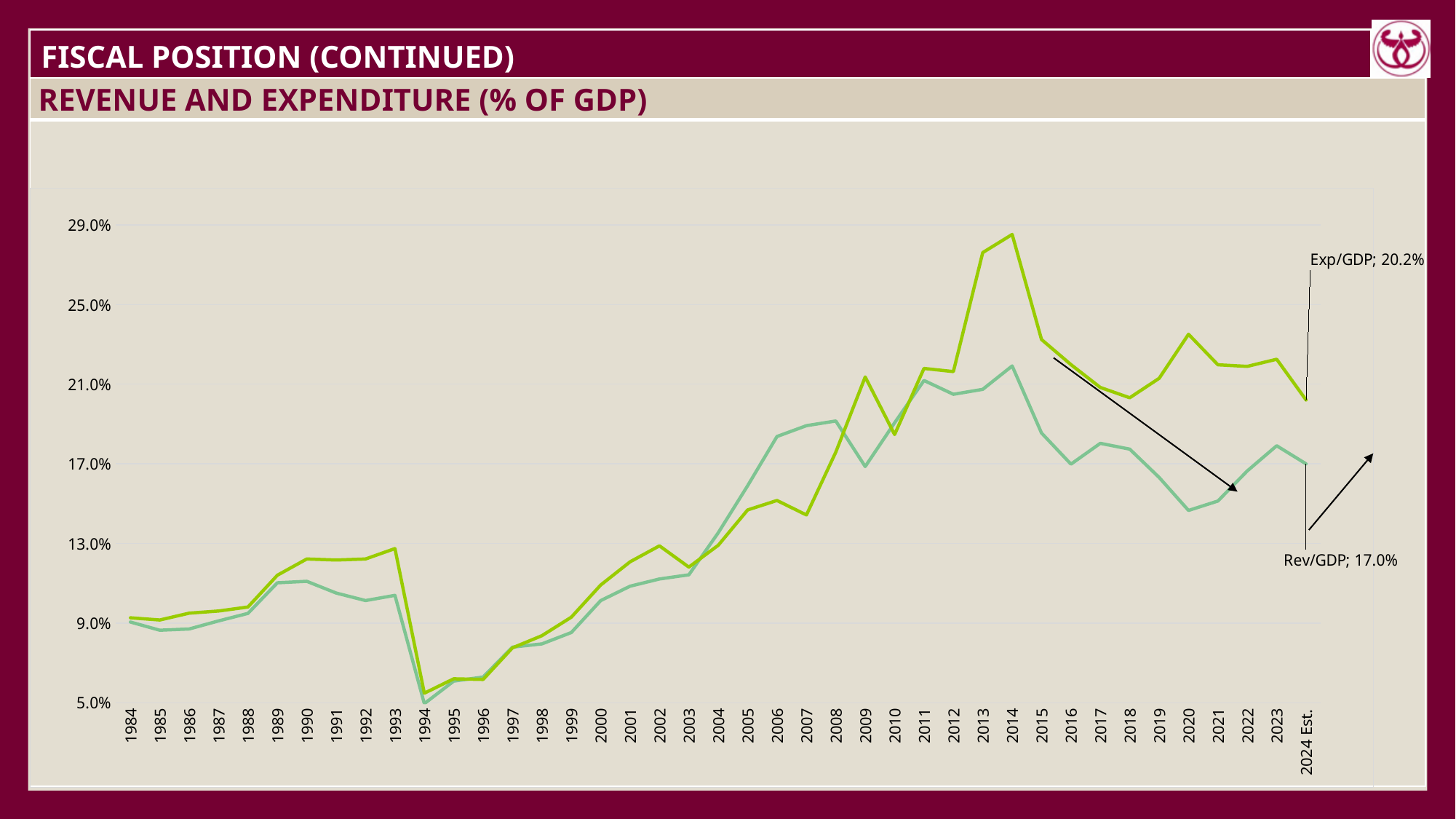
Is the value for Rev/GDP in 1994 greater or less than 9.0%? less What kind of chart is shown on the slide? Line chart What is the value of Exp/GDP for 2024 Est.? 20.2% In which year does the Rev/GDP line reach its lowest value? 1994 What is the difference between Exp/GDP and Rev/GDP for 2024 Est.? 3.2% What is the title of the chart? REVENUE AND EXPENDITURE (% OF GDP) Does the Exp/GDP line rise or fall between 2014 and 2018? Fall For 2024 Est., which is larger, Exp/GDP or Rev/GDP? Exp/GDP In which year does the Exp/GDP line reach its highest value? 2014 Is the value for Exp/GDP in 2014 greater or less than 25.0%? greater How many years are shown on the x axis of the chart? 41 What is the value of Rev/GDP for 2024 Est.? 17.0%